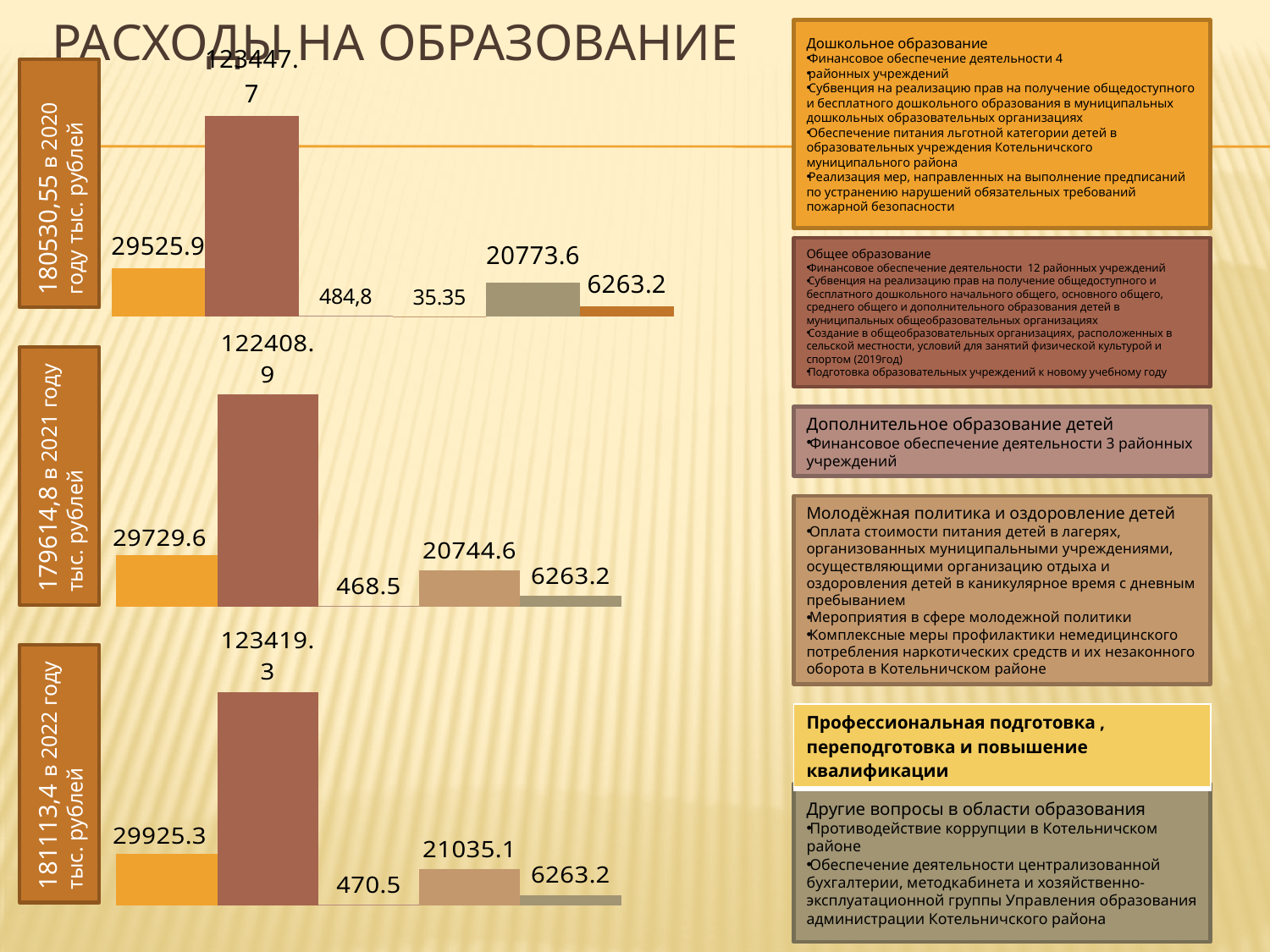
In the bottom chart (2022), what is the value of the last bar on the right? 6263.2 In the top chart (2020), what is the value of the first (orange) bar on the left? 29525.9 In the middle chart (2021), what is the value of the tallest bar? 122408.9 How many bars are shown in the top chart (2020)? 6 Which is larger: the tallest bar in the 2020 chart or the tallest bar in the 2022 chart? 2020 chart (123447.7) In the top chart (2020), what is the value of the tallest bar? 123447.7 What type of chart is used for the 2020 data (top chart)? bar chart In the middle chart (2021), what is the value of the smallest bar? 468.5 In the bottom chart (2022), what is the difference between the first bar (29925.3) and the fourth bar (21035.1)? 8890.2 How many bars are shown in the middle chart (2021)? 5 In the top chart (2020), what is the value of the smallest bar? 35.35 In the bottom chart (2022), what is the value of the first (orange) bar on the left? 29925.3